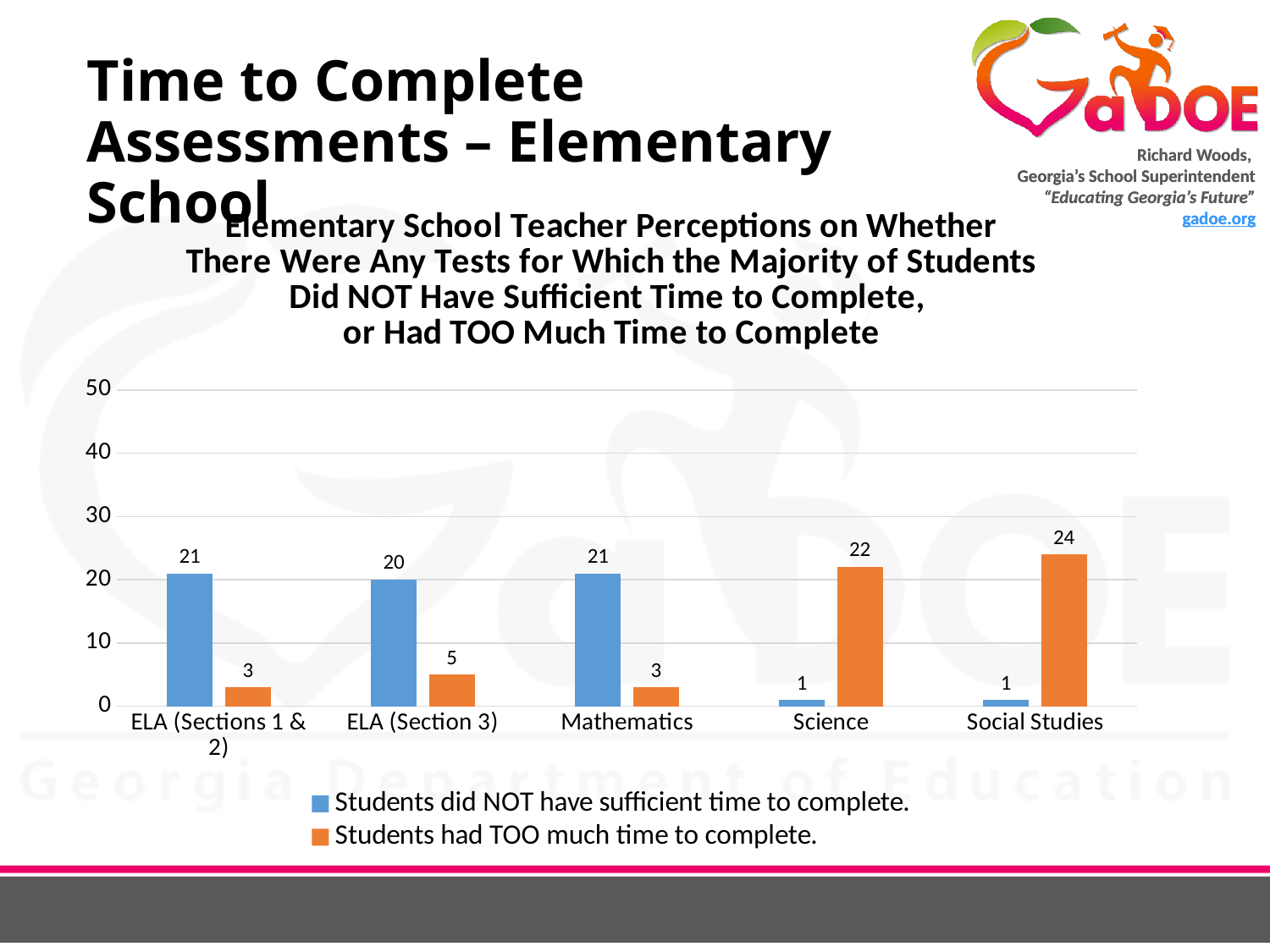
Is the value for Social Studies in the 'Students had TOO much time to complete.' series greater or less than 20? greater What kind of chart is shown on the slide? Bar chart What is the total of the two series for ELA (Section 3)? 25 How many series does the legend list? 2 What is the value for Science in the 'Students had TOO much time to complete.' series? 22 For Mathematics, which series has the larger value? Students did NOT have sufficient time to complete. Which category has the lowest value in the 'Students did NOT have sufficient time to complete.' series? Science and Social Studies (both 1) What is the difference between the two series for Social Studies? 23 Which category has the highest value in the 'Students had TOO much time to complete.' series? Social Studies What colour are the bars for the 'Students had TOO much time to complete.' series? Orange How many categories are shown on the x axis? 5 What is the value for ELA (Section 3) in the 'Students did NOT have sufficient time to complete.' series? 20